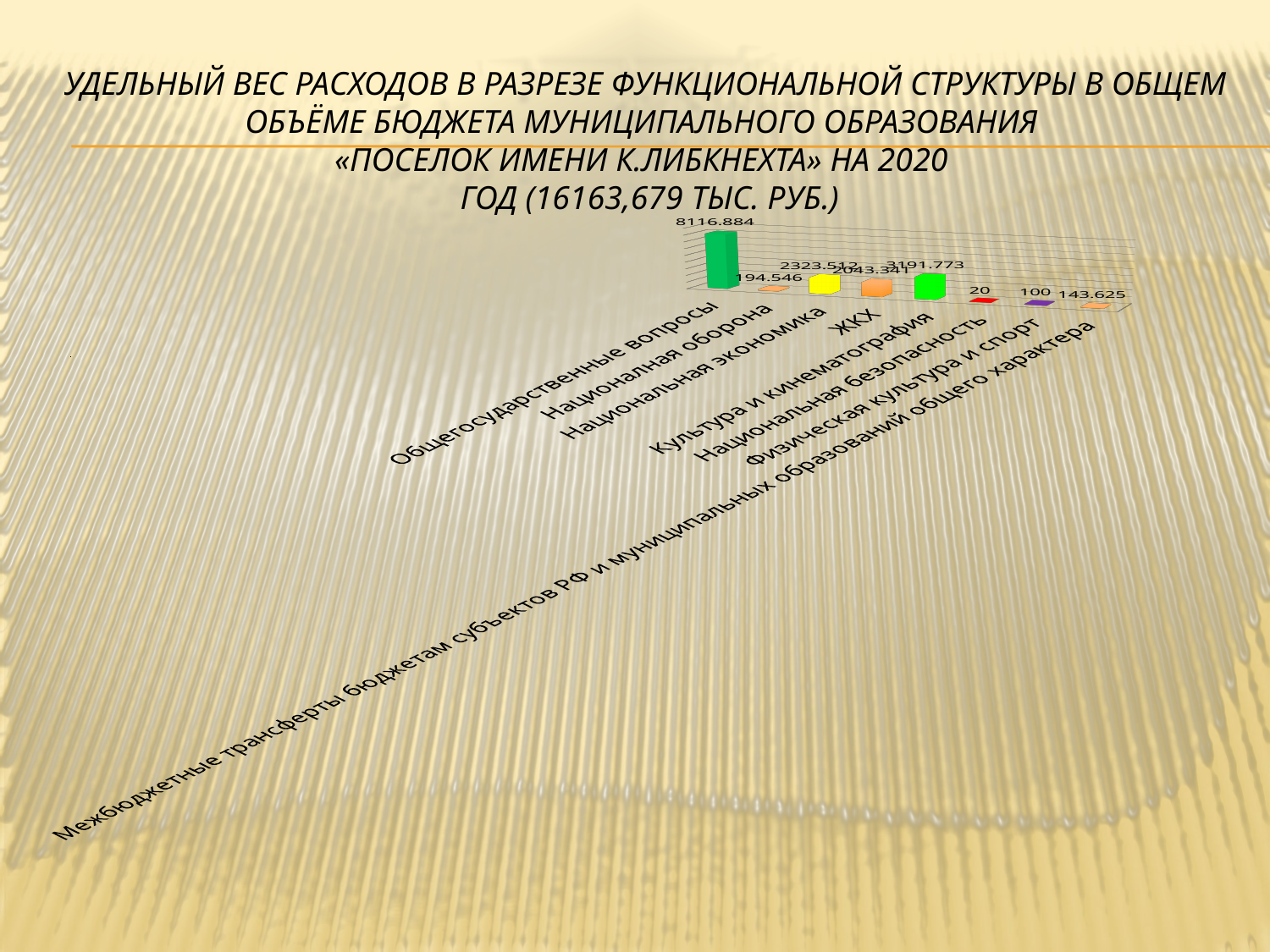
What is the difference between the values for Физическая культура и спорт and Национальная безопасность? 80 What is the value for Национальная оборона? 194.546 Which is larger, the value for Культура и кинематография or the value for Национальная экономика? Культура и кинематография What is the difference between the values for Общегосударственные вопросы and Культура и кинематография? 4925.111 What is the value for Культура и кинематография? 3191.773 Which category has the lowest value? Национальная безопасность What is the value for Национальная безопасность? 20 What is the value for Физическая культура и спорт? 100 How many categories are plotted in the chart? 8 Which category has the highest value? Общегосударственные вопросы What is the value for Общегосударственные вопросы? 8116.884 What type of chart is shown on the slide? bar chart